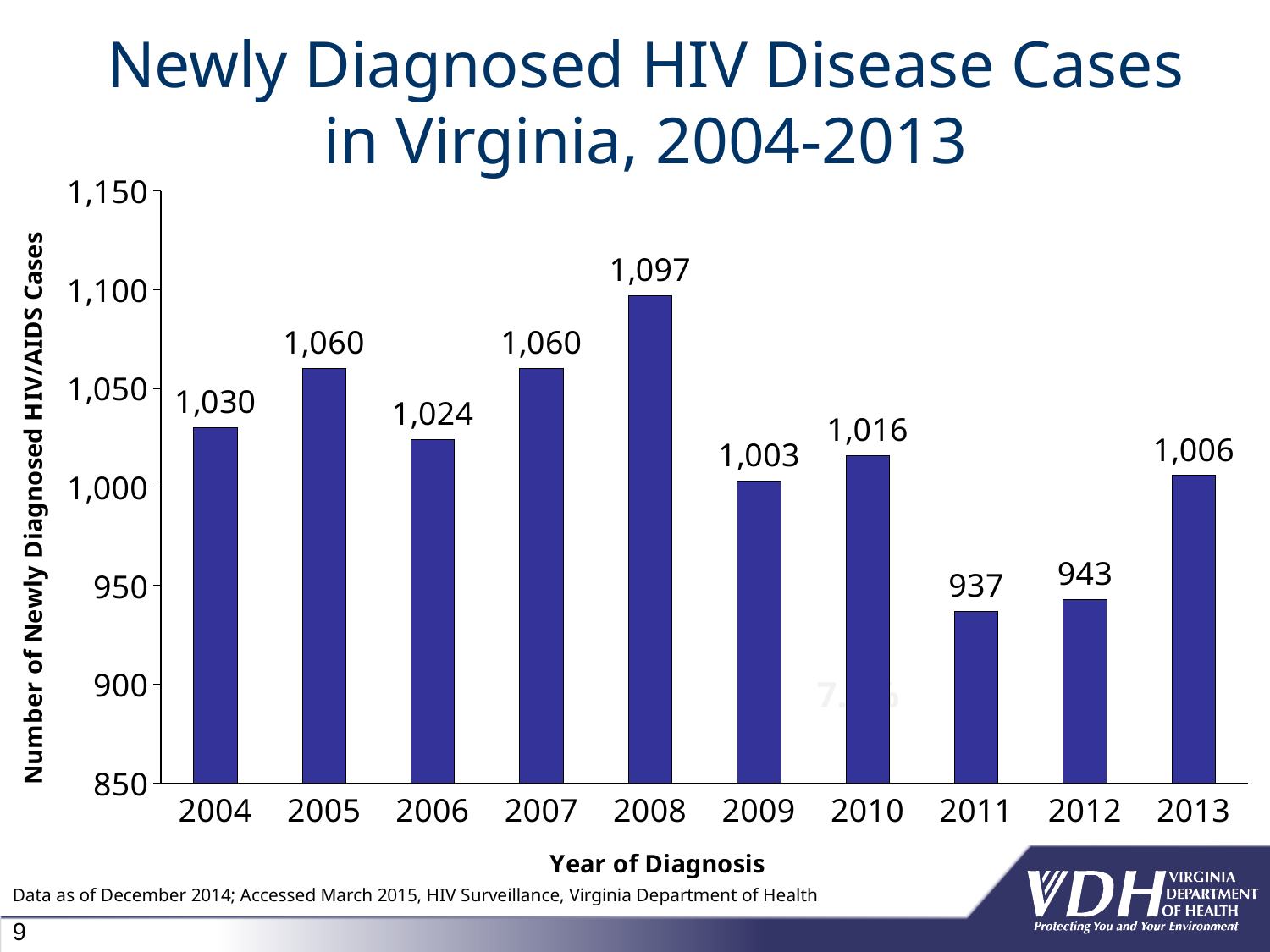
What is the difference in newly diagnosed HIV disease cases between 2012 and 2013? 63 What is the number of newly diagnosed HIV disease cases in Virginia in 2011? 937 What is the number of newly diagnosed HIV disease cases in Virginia in 2013? 1,006 Is the value for 2012 greater or less than 1,000? less Which year has the lowest number of newly diagnosed HIV disease cases? 2011 Which year had more newly diagnosed HIV disease cases, 2004 or 2006? 2004 What is the label of the y axis of the chart? Number of Newly Diagnosed HIV/AIDS Cases How many years are shown on the x axis of the chart? 10 What kind of chart is shown on the slide? Bar chart What is the difference in newly diagnosed HIV disease cases between 2008 and 2011? 160 Which year has the highest number of newly diagnosed HIV disease cases? 2008 What is the number of newly diagnosed HIV disease cases in Virginia in 2008? 1,097